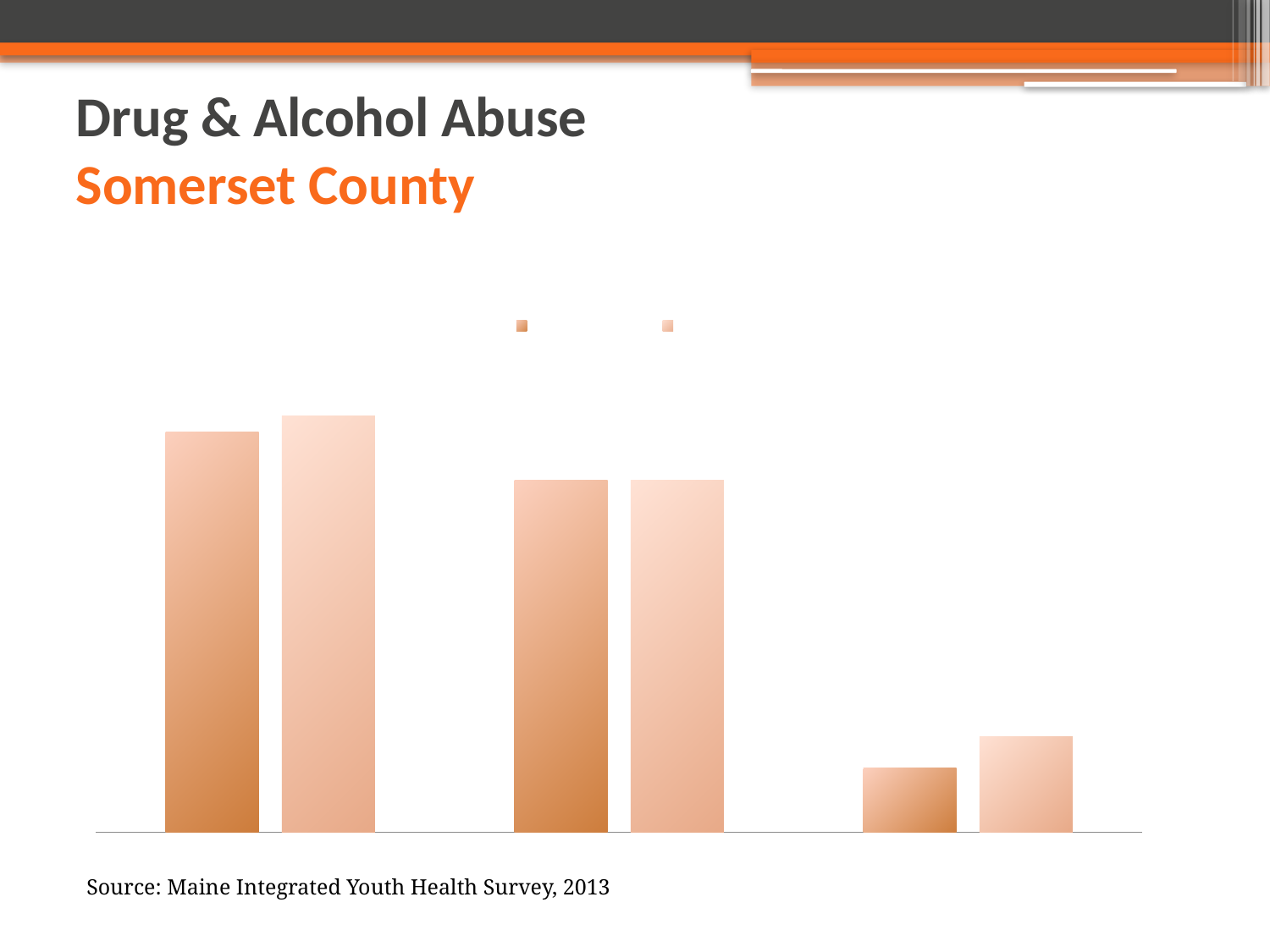
How many groups of bars are plotted in the chart? 3 In the third group of bars from the left, is the darker bar or the lighter bar taller? the lighter bar What kind of chart is shown on the slide? bar chart Do the bar heights rise or fall moving from the left group to the right group? fall In the first group of bars from the left, is the darker bar or the lighter bar taller? the lighter bar What county is named in the slide title above the chart? Somerset County How many series does the chart's legend show? 2 Which group of bars, counting from the left, has the highest values? the first group What source is cited below the chart? Maine Integrated Youth Health Survey, 2013 How many bars are plotted in the chart in total? 6 Which group of bars, counting from the left, has the lowest values? the third group